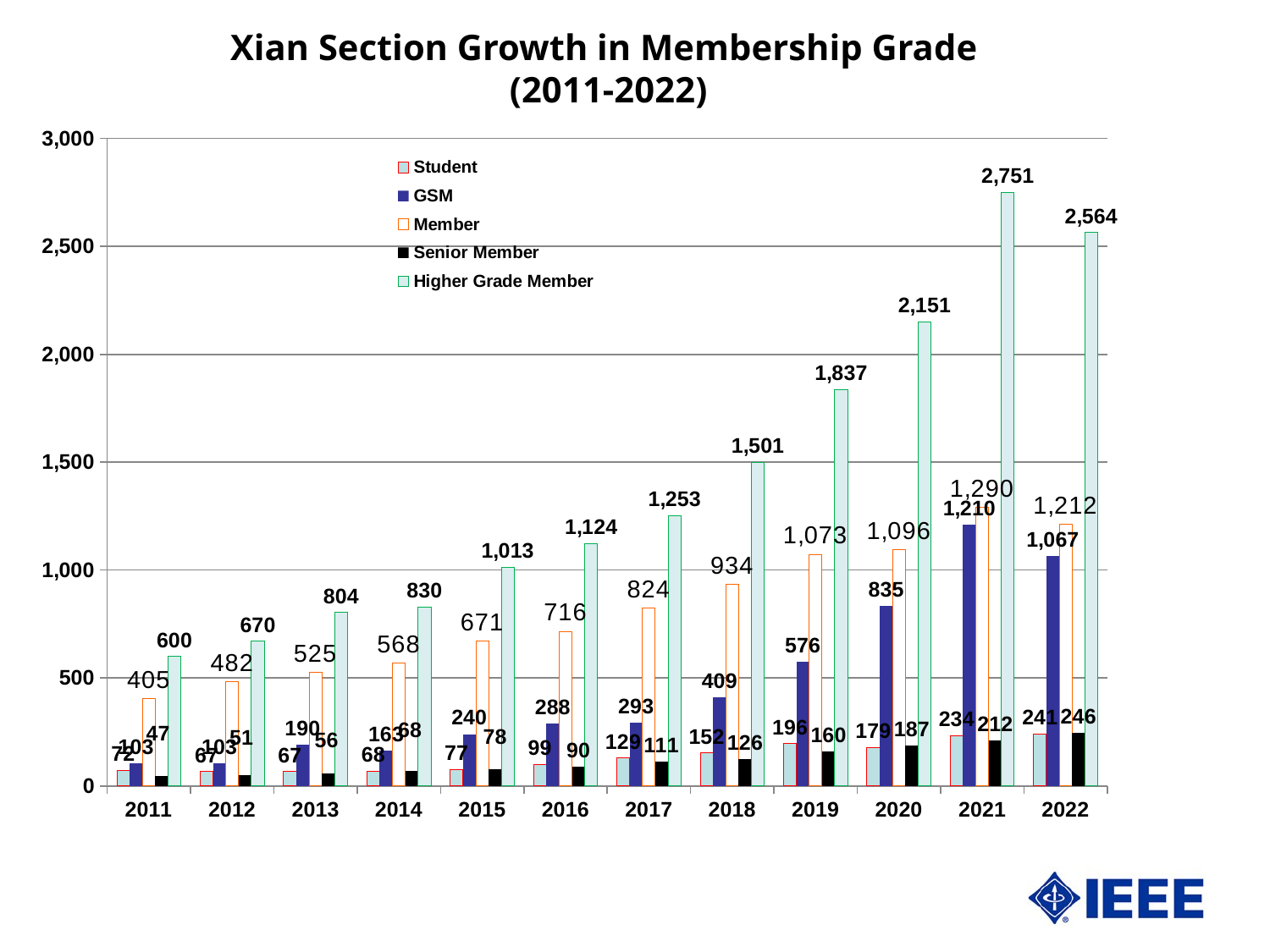
Is the Member value for 2019 greater or less than 1,000? greater What is the value for Higher Grade Member in 2021? 2,751 What is the value for Senior Member in 2022? 246 How many series does the legend list? 5 What is the value for Member in 2018? 934 In which year is the Higher Grade Member value highest? 2021 Which is larger, the GSM value in 2021 or the GSM value in 2022? 2021 What is the difference between the Higher Grade Member values for 2021 and 2022? 187 How many years are shown on the x axis? 12 What is the value for GSM in 2020? 835 What kind of chart is shown on the slide? Bar chart In which year is the Higher Grade Member value lowest? 2011